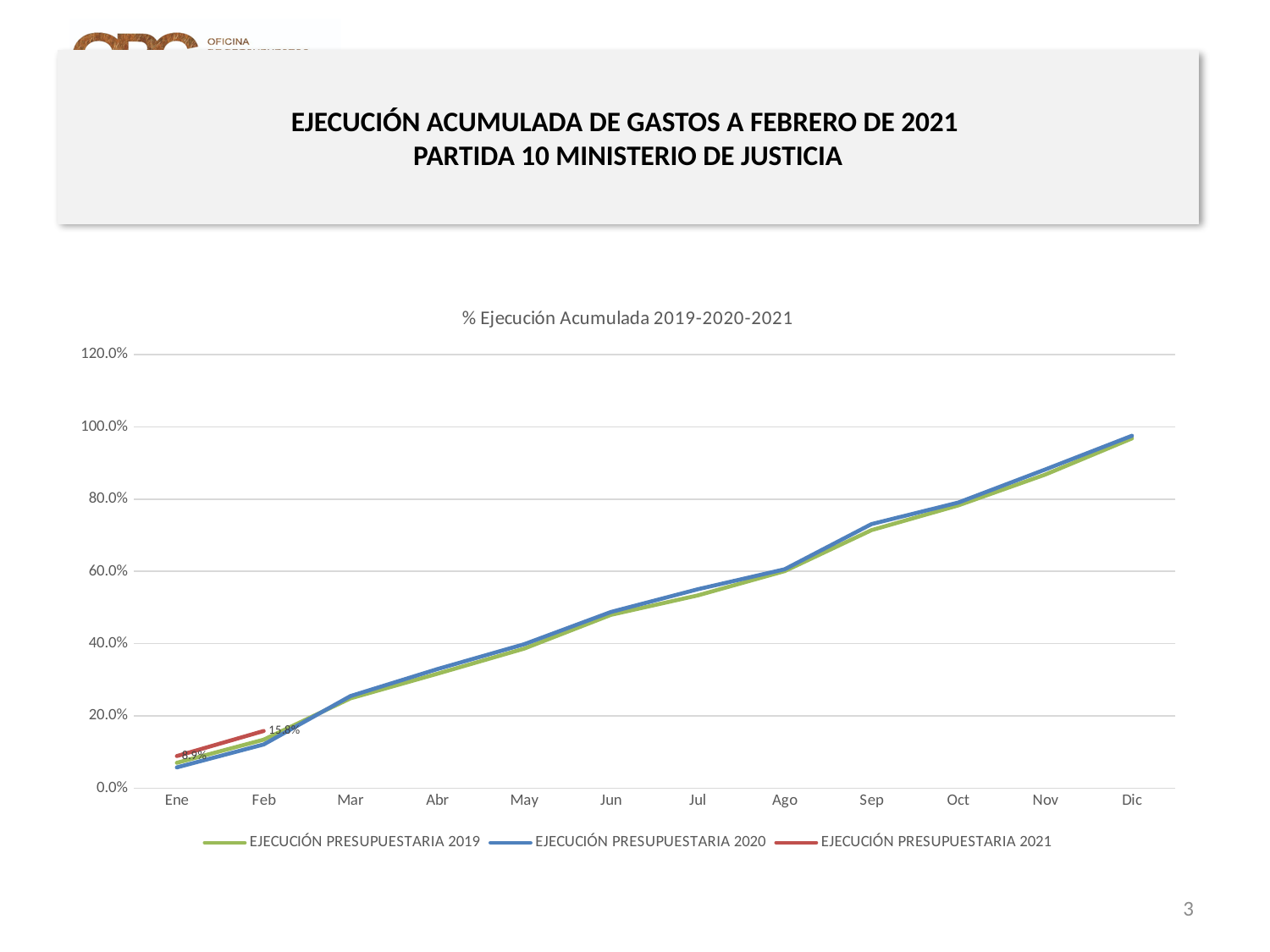
How many months are shown along the x axis? 12 Is the value for EJECUCIÓN PRESUPUESTARIA 2019 in Mar greater or less than 40.0%? less What is the value for EJECUCIÓN PRESUPUESTARIA 2021 in Ene? 8.9% How many series does the legend list? 3 Do the values for EJECUCIÓN PRESUPUESTARIA 2020 rise or fall from Ene to Dic? rise Is the value for EJECUCIÓN PRESUPUESTARIA 2020 in Dic greater or less than 80.0%? greater What is the title of the chart? % Ejecución Acumulada 2019-2020-2021 For EJECUCIÓN PRESUPUESTARIA 2021, which month has the larger value, Ene or Feb? Feb What kind of chart is shown on the slide? line chart What is the value for EJECUCIÓN PRESUPUESTARIA 2021 in Feb? 15.8% Which series is drawn in red? EJECUCIÓN PRESUPUESTARIA 2021 What is the difference between the Feb and Ene values for EJECUCIÓN PRESUPUESTARIA 2021? 6.9%